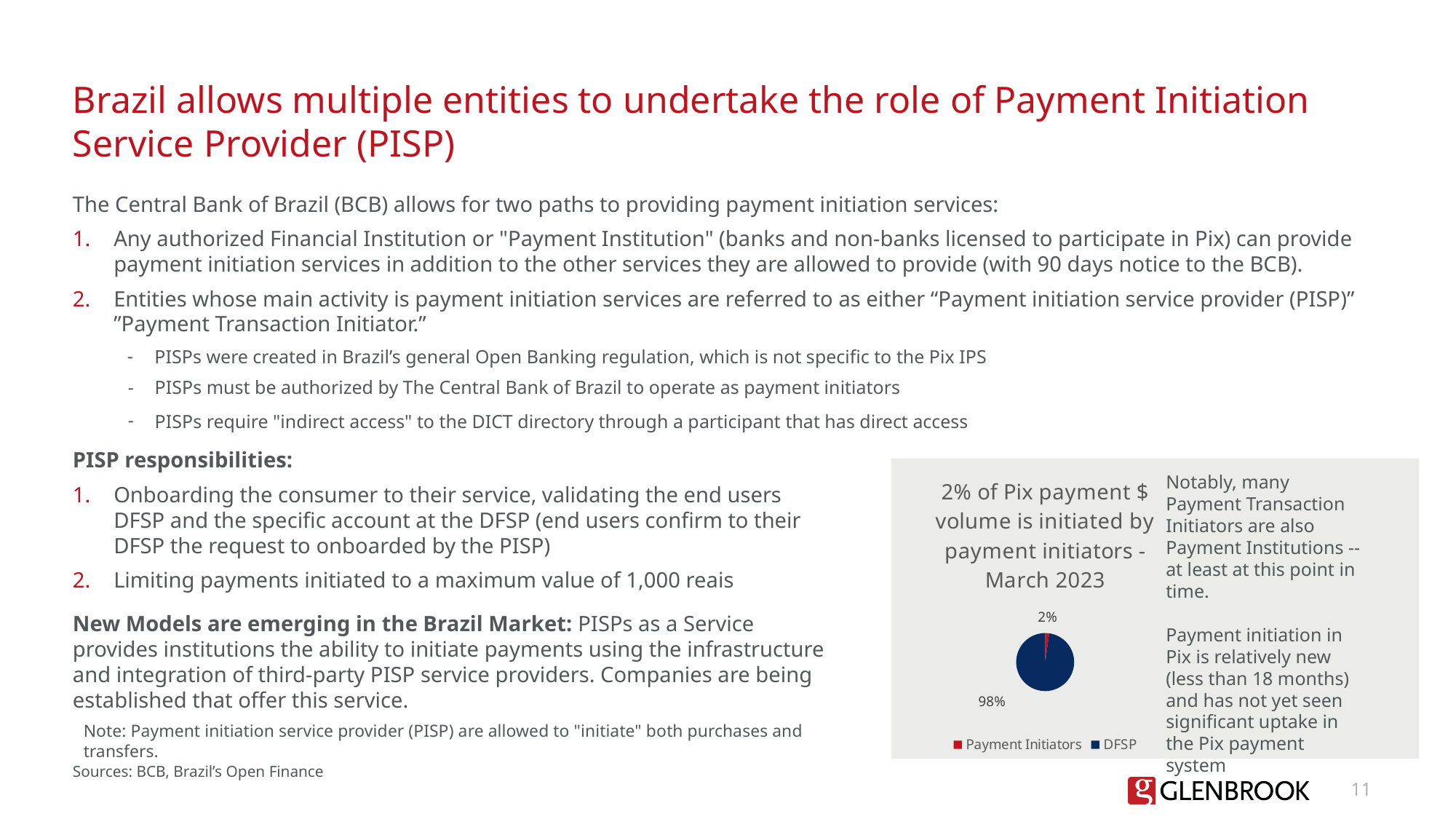
Which is larger in the pie chart, the Payment Initiators slice or the DFSP slice? DFSP Which slice of the pie chart is the largest? DFSP How many entries does the pie chart's legend list? 2 What is the difference in percentage points between the DFSP slice and the Payment Initiators slice? 96 percentage points What share of Pix payment $ volume is attributed to Payment Initiators in the pie chart? 2% How many slices does the pie chart have? 2 What is the title of the pie chart? 2% of Pix payment $ volume is initiated by payment initiators - March 2023 What colour is the Payment Initiators slice in the pie chart? red Which slice of the pie chart is the smallest? Payment Initiators What kind of chart is shown on the slide? pie chart What share of Pix payment $ volume is attributed to DFSP in the pie chart? 98%